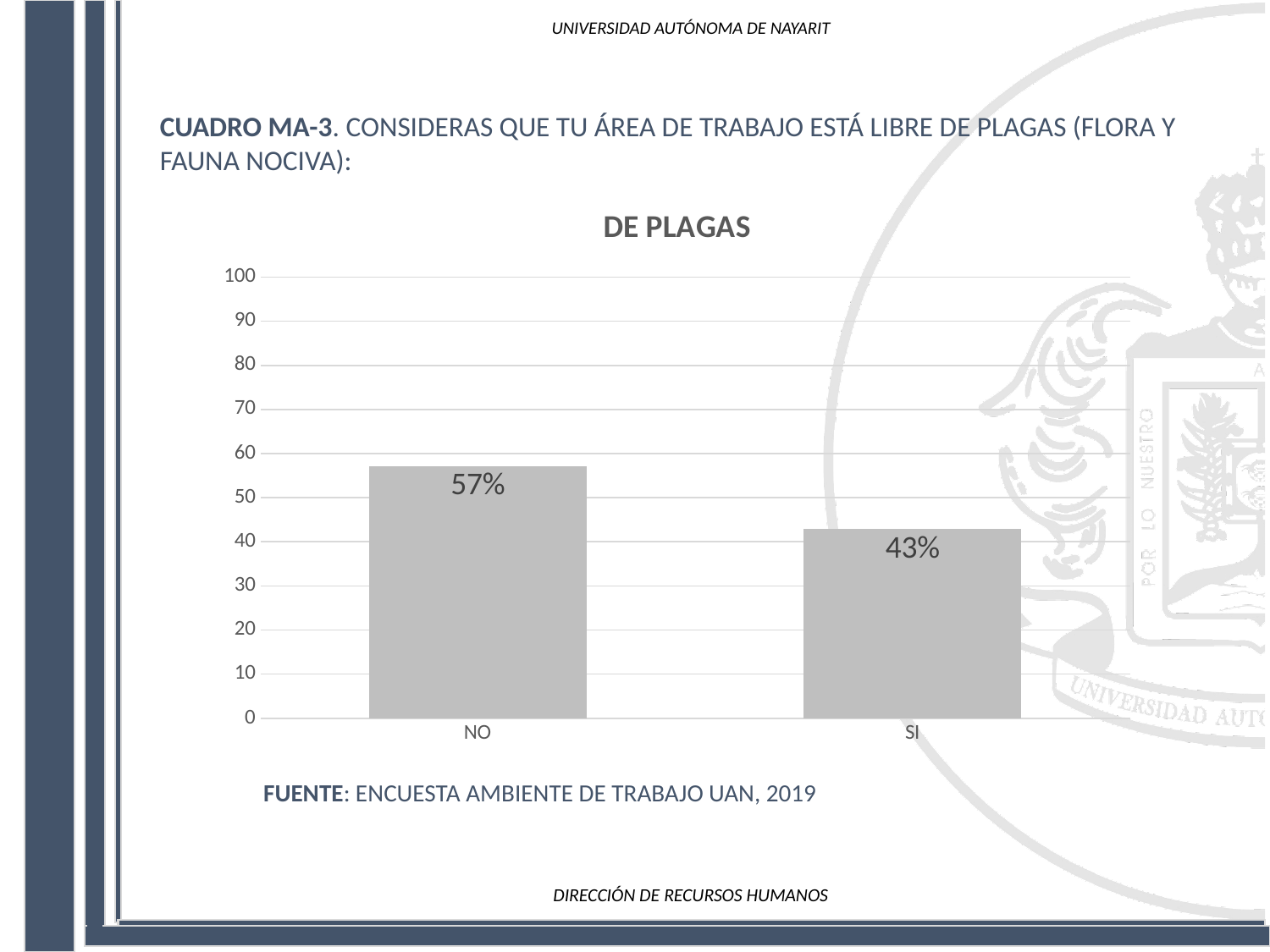
Which is larger, the value for NO or the value for SI? NO What is the value for NO? 57% What is the title of the chart? DE PLAGAS What kind of chart is shown on the slide? bar chart What is the difference between the values for NO and SI? 14% Which category has the highest value? NO Which category has the lowest value? SI What is the maximum value shown on the vertical axis? 100 Is the value for NO greater or less than 50? greater What is the value for SI? 43% How many categories are shown on the x axis? 2 Is the value for SI greater or less than 50? less